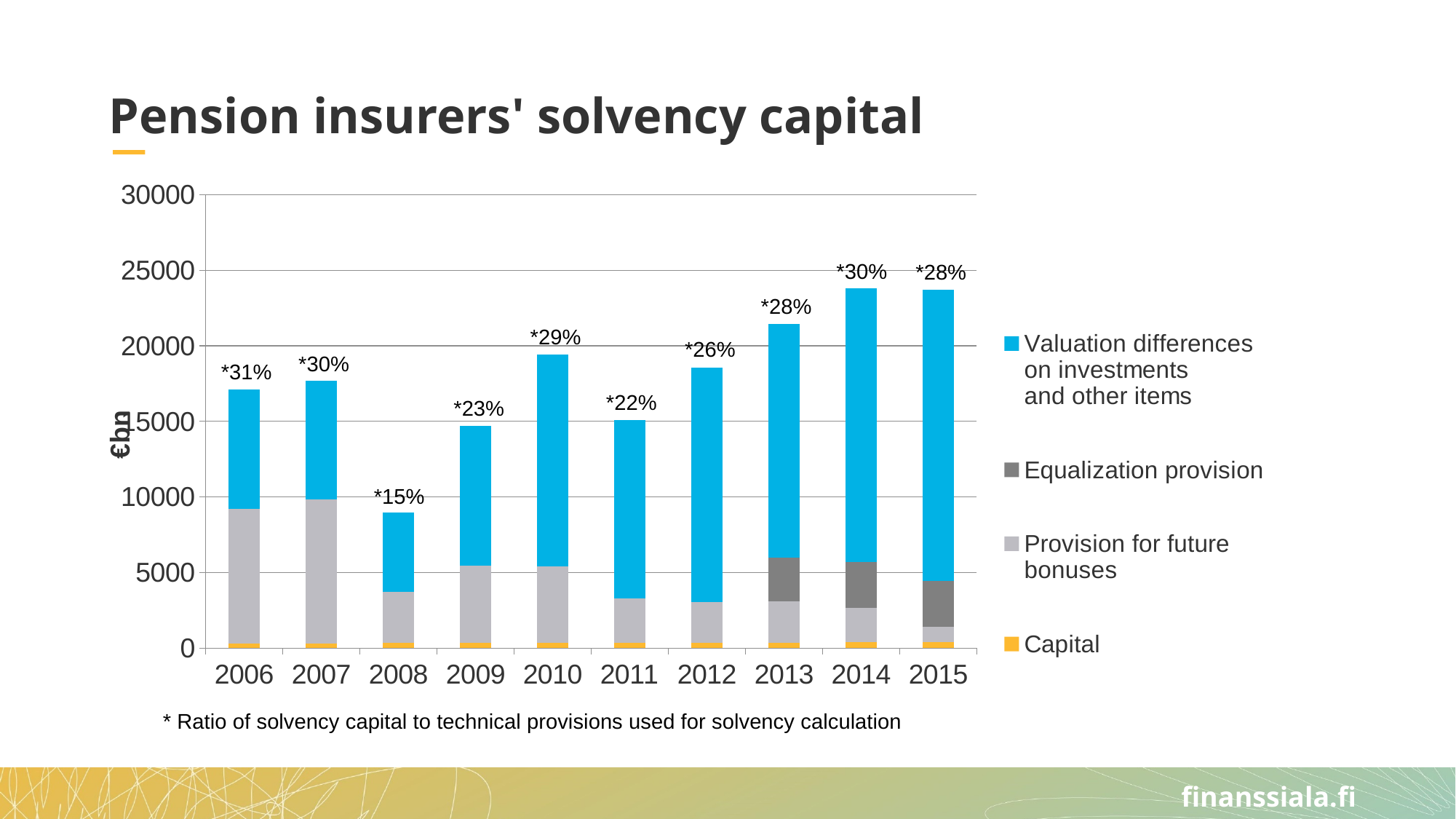
Which year has the lowest ratio of solvency capital to technical provisions printed above its bar? 2008 Which bar is taller in total, 2014 or 2008? 2014 What is the difference in percentage points between the ratios printed above the 2006 and 2008 bars? 16 percentage points What ratio of solvency capital to technical provisions is printed above the 2010 bar? 29% What kind of chart is shown on the slide? bar chart Is the total height of the 2014 bar greater or less than 20000? greater Which series is shown in orange in the legend? Capital Which year has the highest ratio of solvency capital to technical provisions printed above its bar? 2006 Is the total height of the 2008 bar greater or less than 10000? less How many years are shown on the x axis of the chart? 10 What ratio of solvency capital to technical provisions is printed above the 2008 bar? 15% How many series does the chart's legend list? 4